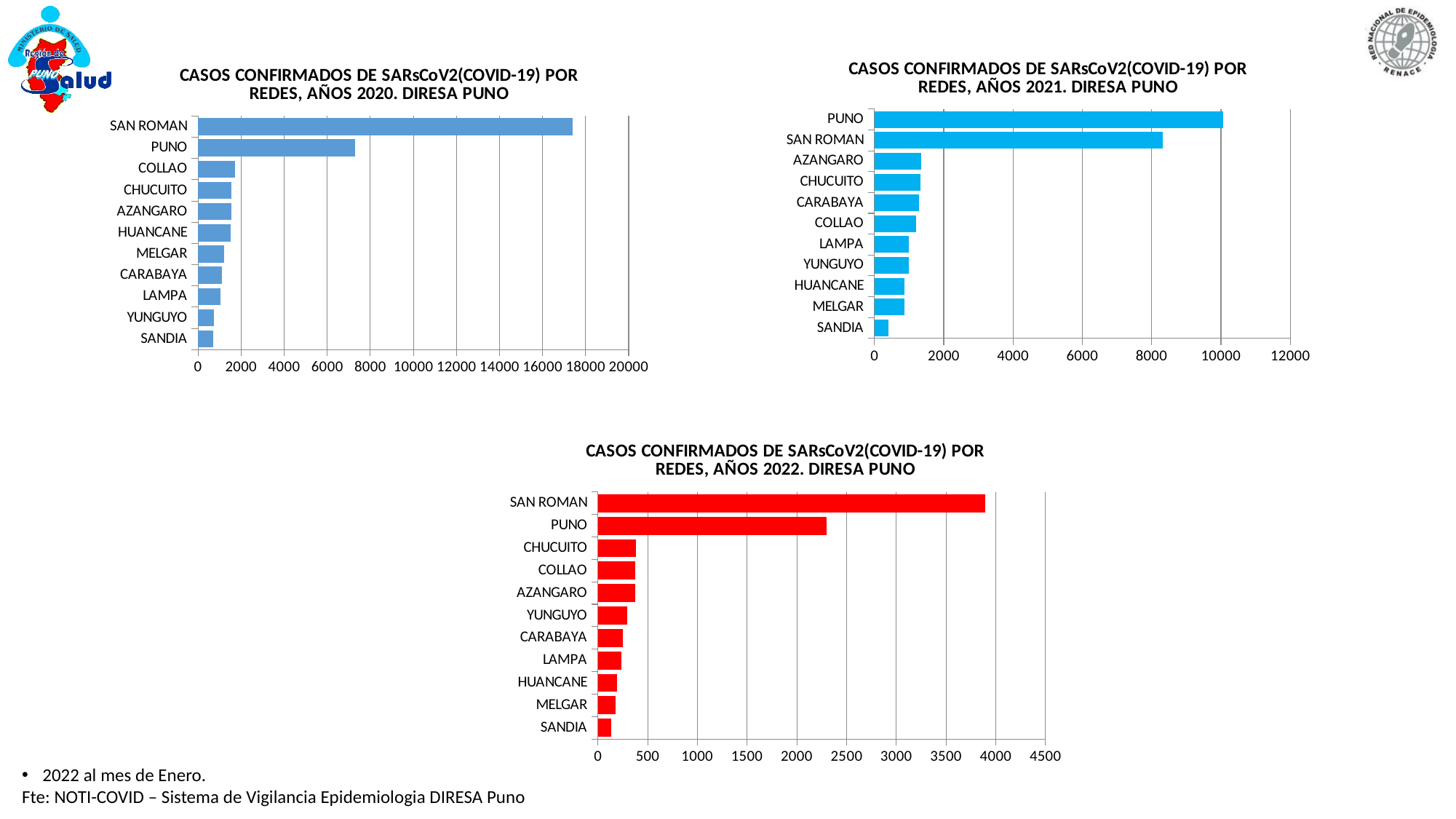
What kind of chart is the 2022 chart at the bottom of the slide? Bar chart How many redes (categories) are shown in the 2022 chart (bottom)? 11 In the chart titled 'CASOS CONFIRMADOS DE SARsCoV2(COVID-19) POR REDES, AÑOS 2020. DIRESA PUNO', which red has the highest number of confirmed cases? SAN ROMAN In the chart titled 'CASOS CONFIRMADOS DE SARsCoV2(COVID-19) POR REDES, AÑOS 2022. DIRESA PUNO', which red has the highest number of confirmed cases? SAN ROMAN In the 2021 chart (top right), is the value for SANDIA greater or less than 1000? less In the 2021 chart (top right), which red has the lowest number of confirmed cases? SANDIA In the 2020 chart (top left), which has more confirmed cases, PUNO or COLLAO? PUNO In the 2020 chart (top left), is the value for SAN ROMAN greater or less than 16000? greater In the 2020 chart (top left), is the value for PUNO greater or less than 8000? less In the chart titled 'CASOS CONFIRMADOS DE SARsCoV2(COVID-19) POR REDES, AÑOS 2021. DIRESA PUNO', which red has the highest number of confirmed cases? PUNO